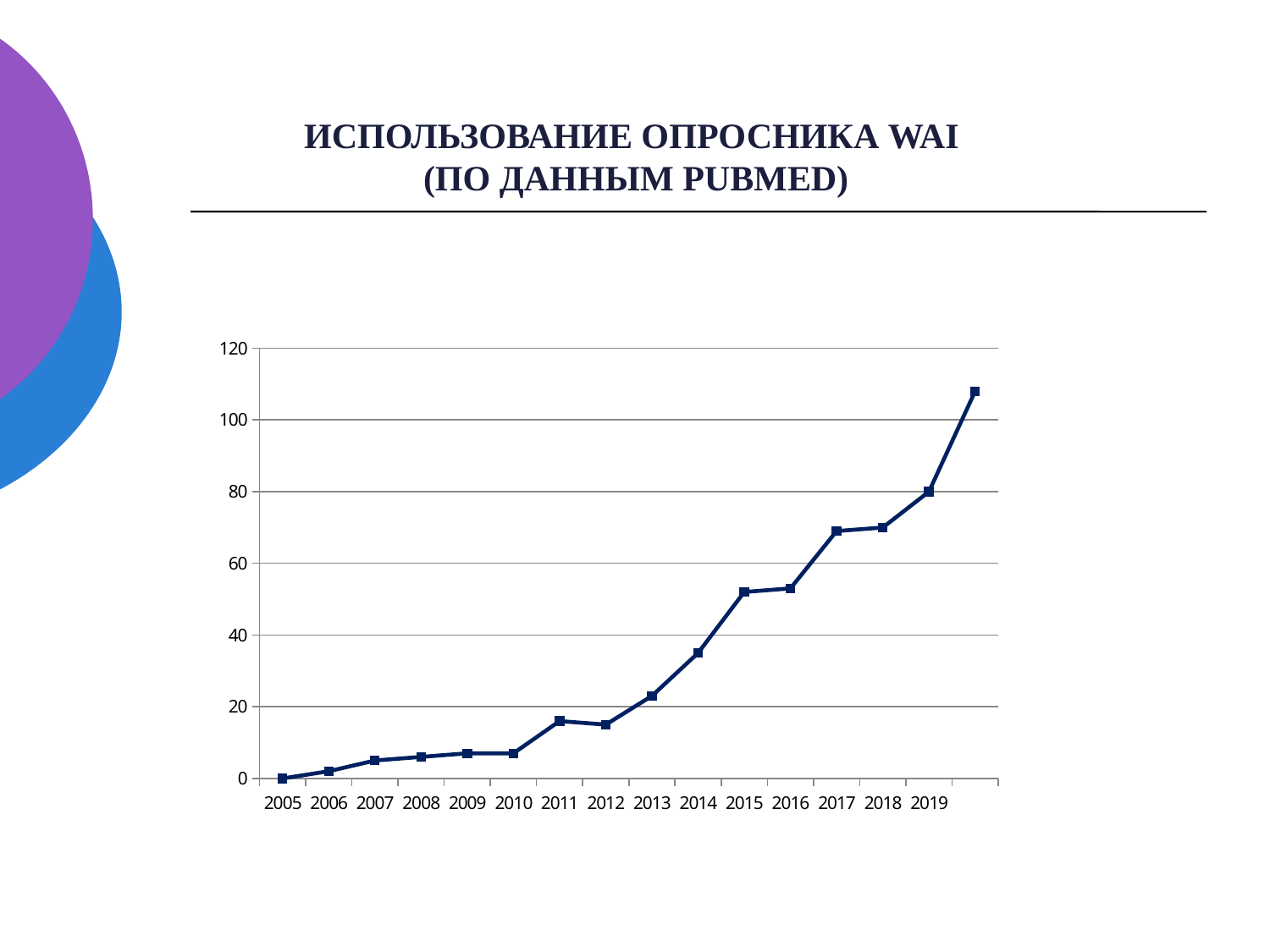
Which labeled year has the lowest value? 2005 What is the value for 2005? 0 Is the value for 2011 greater or less than 20? less Is the value for 2014 greater or less than 40? less Do the values generally rise or fall from 2005 to 2019? rise How many years are labeled on the x axis? 15 What kind of chart is shown on the slide? line chart Which is larger, the value for 2013 or the value for 2017? 2017 What is the title of the chart on the slide? ИСПОЛЬЗОВАНИЕ ОПРОСНИКА WAI (ПО ДАННЫМ PUBMED) Is the value for 2017 greater or less than 60? greater Which labeled year has the highest value? 2019